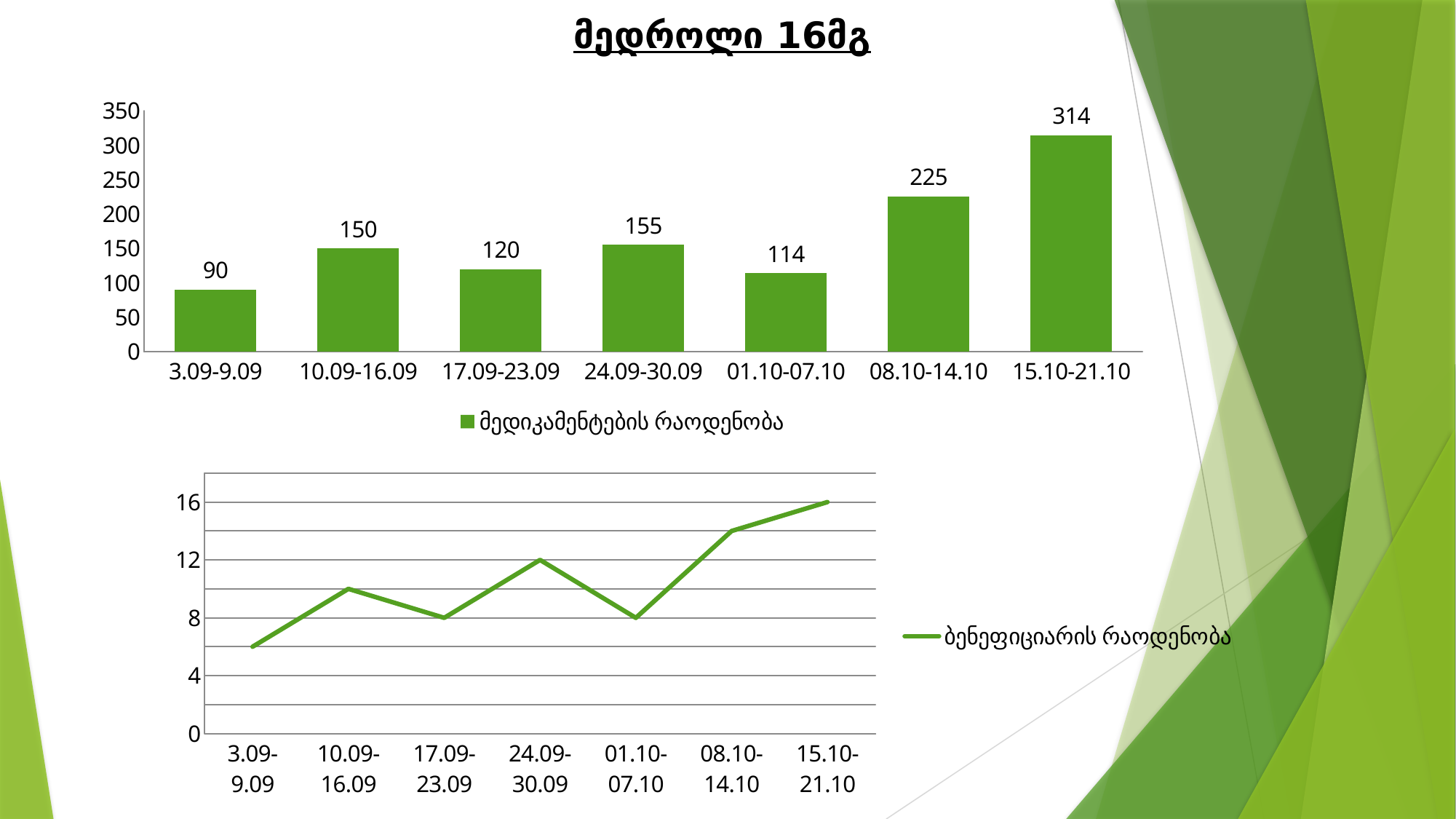
In the top bar chart, which period has the lowest value? 3.09-9.09 In the bottom line chart, is the value for 3.09-9.09 greater or less than 8? less What type of chart is the bottom chart on the slide? line chart In the top bar chart, what is the value for 15.10-21.10? 314 In the top bar chart, which period has the highest value? 15.10-21.10 In the bottom line chart, what is the value for 15.10-21.10? 16 In the bottom line chart, which period has the highest value? 15.10-21.10 What type of chart is the top chart on the slide? bar chart In the top bar chart, what is the value for 01.10-07.10? 114 In the top bar chart, what is the difference between the values for 08.10-14.10 and 24.09-30.09? 70 How many bars are in the top bar chart? 7 In the top bar chart, which is larger: the value for 10.09-16.09 or the value for 17.09-23.09? 10.09-16.09